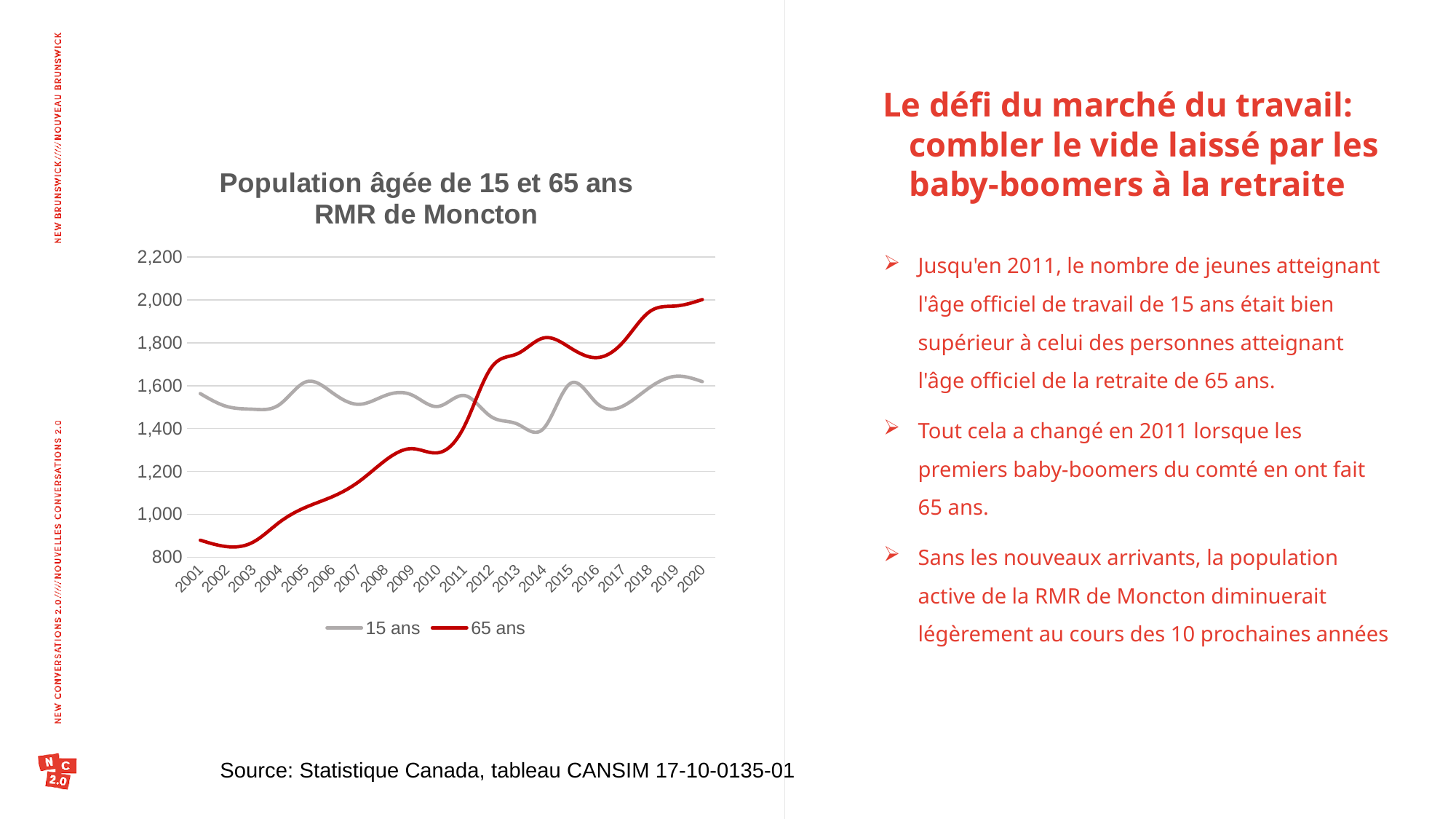
In which year is the 65 ans series at its highest? 2020 Does the 65 ans series generally rise or fall from 2001 to 2020? Rise What are the two series named in the legend? 15 ans and 65 ans How many years are shown on the x axis? 20 In 2020, which series has the larger value, 15 ans or 65 ans? 65 ans What is the title of the chart? Population âgée de 15 et 65 ans RMR de Moncton How many series does the legend list? 2 Is the value for 65 ans in 2001 greater or less than 1,000? less In 2001, which series has the larger value, 15 ans or 65 ans? 15 ans What kind of chart is shown on the slide? Line chart In which year is the 15 ans series at its lowest? 2014 Is the value for 65 ans in 2020 greater or less than 1,800? greater